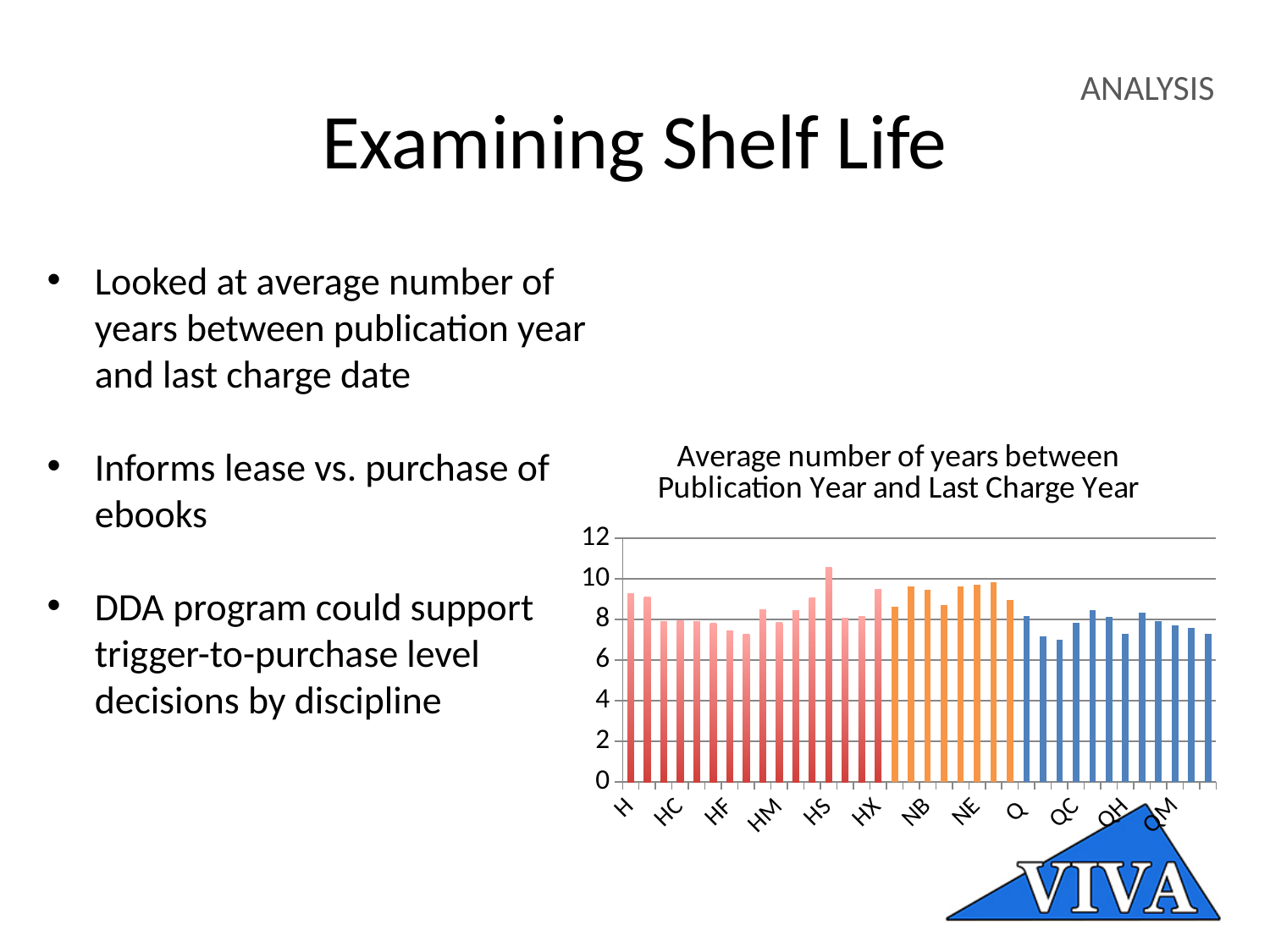
Is the value for H greater or less than 8? greater Is the value for QC greater or less than 6? greater Is the value for H greater or less than 10? less What is the highest value shown on the chart's vertical axis? 12 What kind of chart is shown on the slide? bar chart What is the title of the chart? Average number of years between Publication Year and Last Charge Year